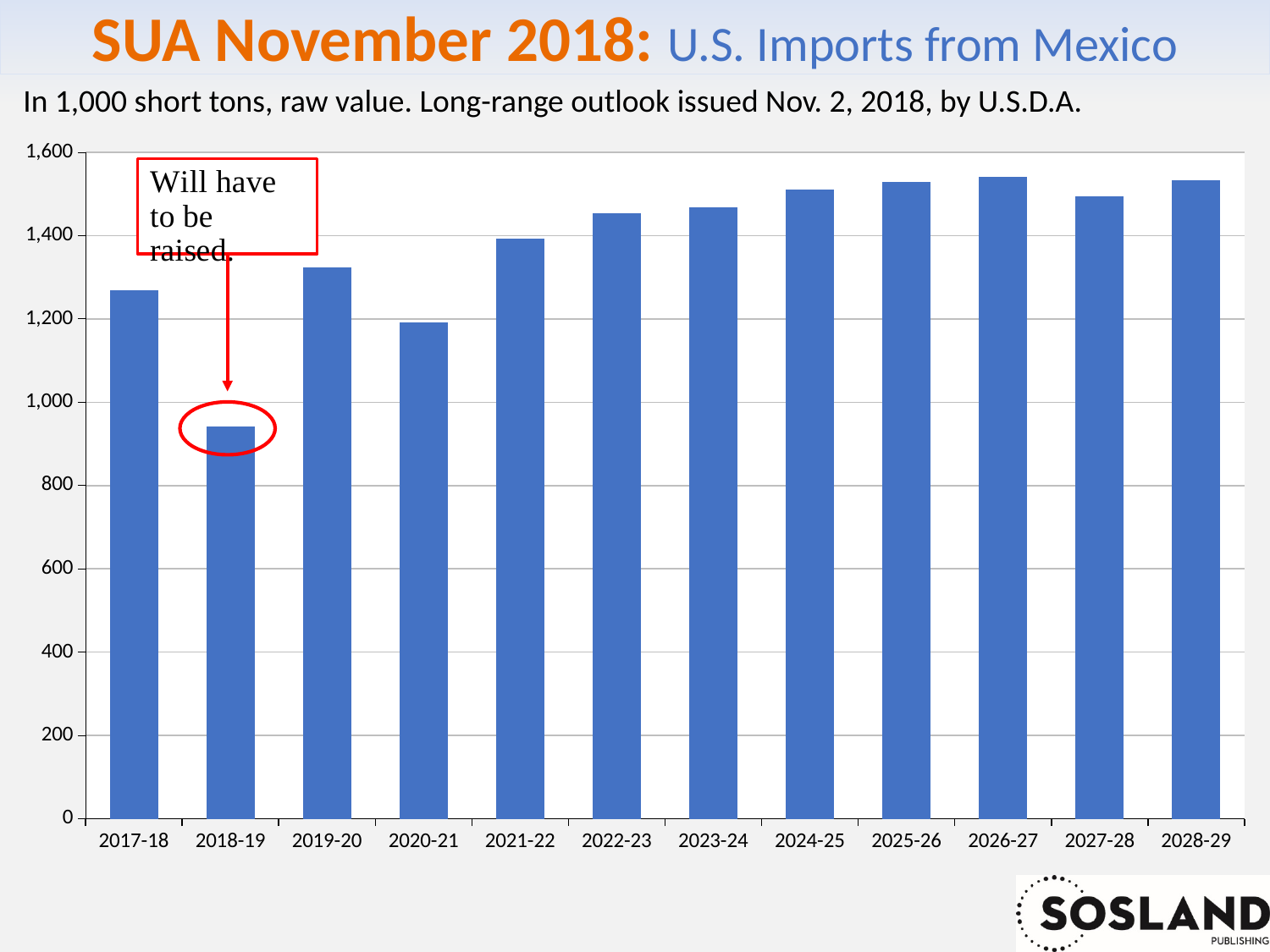
What does the red annotation box on the chart say about the 2018-19 bar? Will have to be raised. Is the value for 2022-23 greater or less than 1,400? greater How many marketing years are shown on the x axis of the chart? 12 Do the values rise or fall from 2020-21 to 2026-27? rise Which is larger, the value for 2019-20 or the value for 2020-21? 2019-20 Which is larger, the value for 2017-18 or the value for 2018-19? 2017-18 What kind of chart is shown on the slide? Bar chart Is the value for 2018-19 greater or less than 1,000? less Which year has the lowest U.S. imports from Mexico in the chart? 2018-19 Is the value for 2017-18 greater or less than 1,200? greater